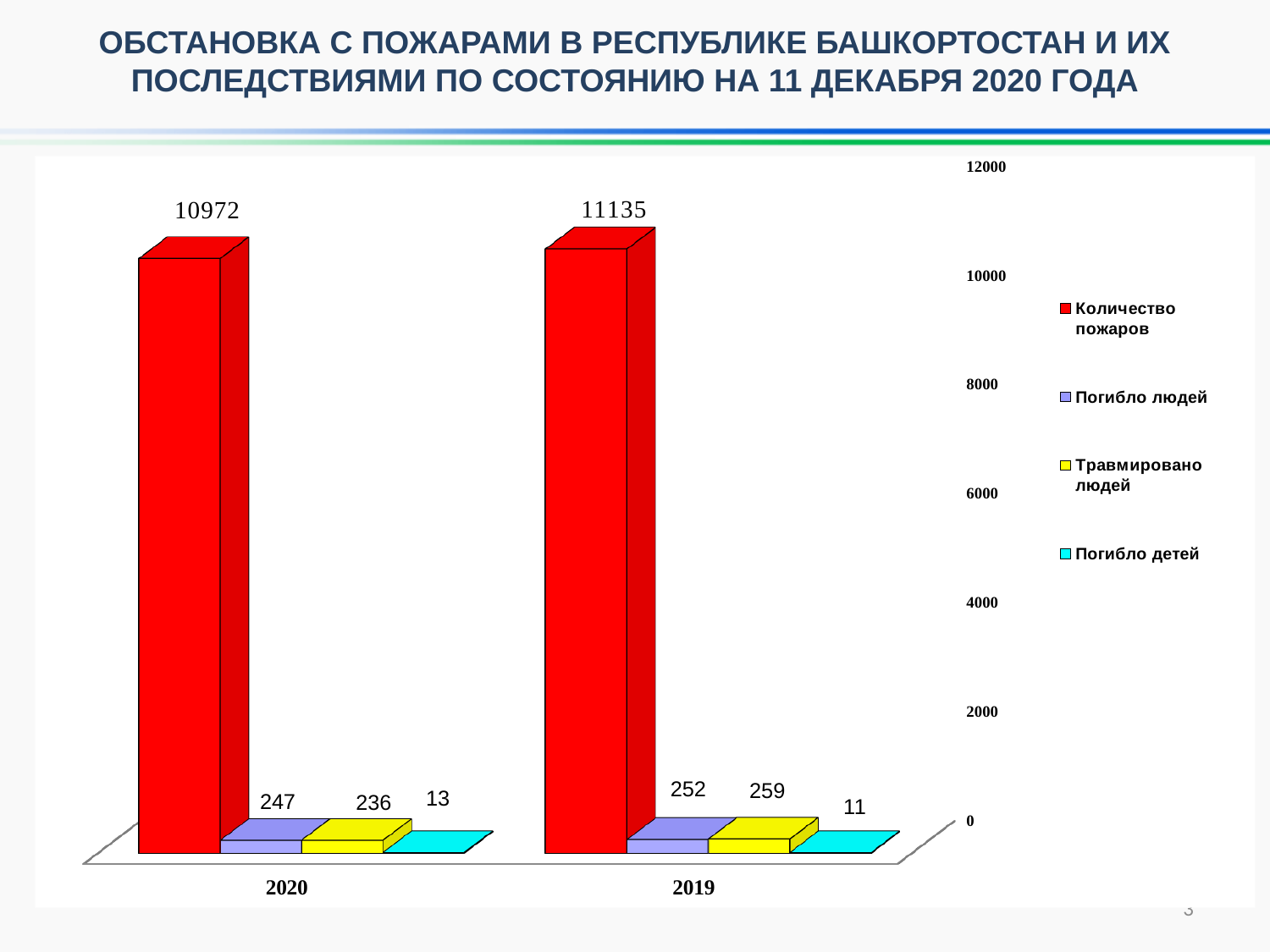
What kind of chart is shown on the slide? Bar chart Which year has the higher value for Количество пожаров, 2020 or 2019? 2019 What is the difference between the Погибло людей values for 2019 and 2020? 5 What is the value of Погибло детей for 2020? 13 How many series does the legend list? 4 Which year has the higher value for Погибло детей, 2020 or 2019? 2020 What is the value of Количество пожаров for 2020? 10972 What is the difference between the Количество пожаров values for 2019 and 2020? 163 How many categories are shown on the x axis? 2 What is the value of Количество пожаров for 2019? 11135 What is the value of Погибло людей for 2020? 247 What is the value of Травмировано людей for 2019? 259